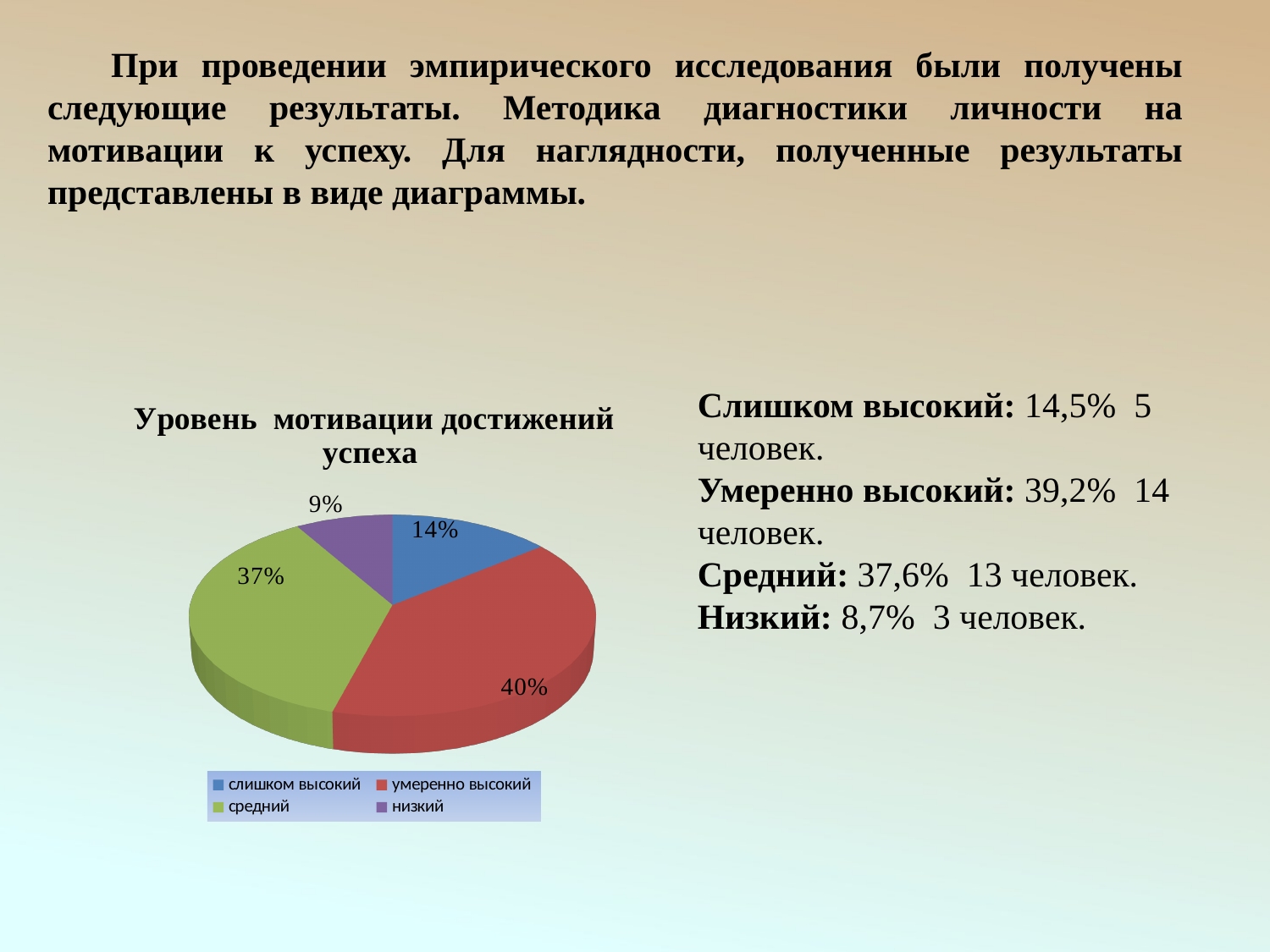
Which slice is larger, 'слишком высокий' or 'низкий'? слишком высокий How many entries does the legend list? 4 Which category has the largest share of the pie? умеренно высокий What percentage does the 'низкий' slice show? 9% What percentage does the 'слишком высокий' slice show? 14% What type of chart is shown on the slide? pie chart What is the difference in percentage points between the 'умеренно высокий' and 'средний' slices? 3 What percentage does the 'средний' slice show? 37% Which category has the smallest share of the pie? низкий What is the title of the chart? Уровень мотивации достижений успеха What percentage does the 'умеренно высокий' slice show? 40% How many slices does the pie chart have? 4